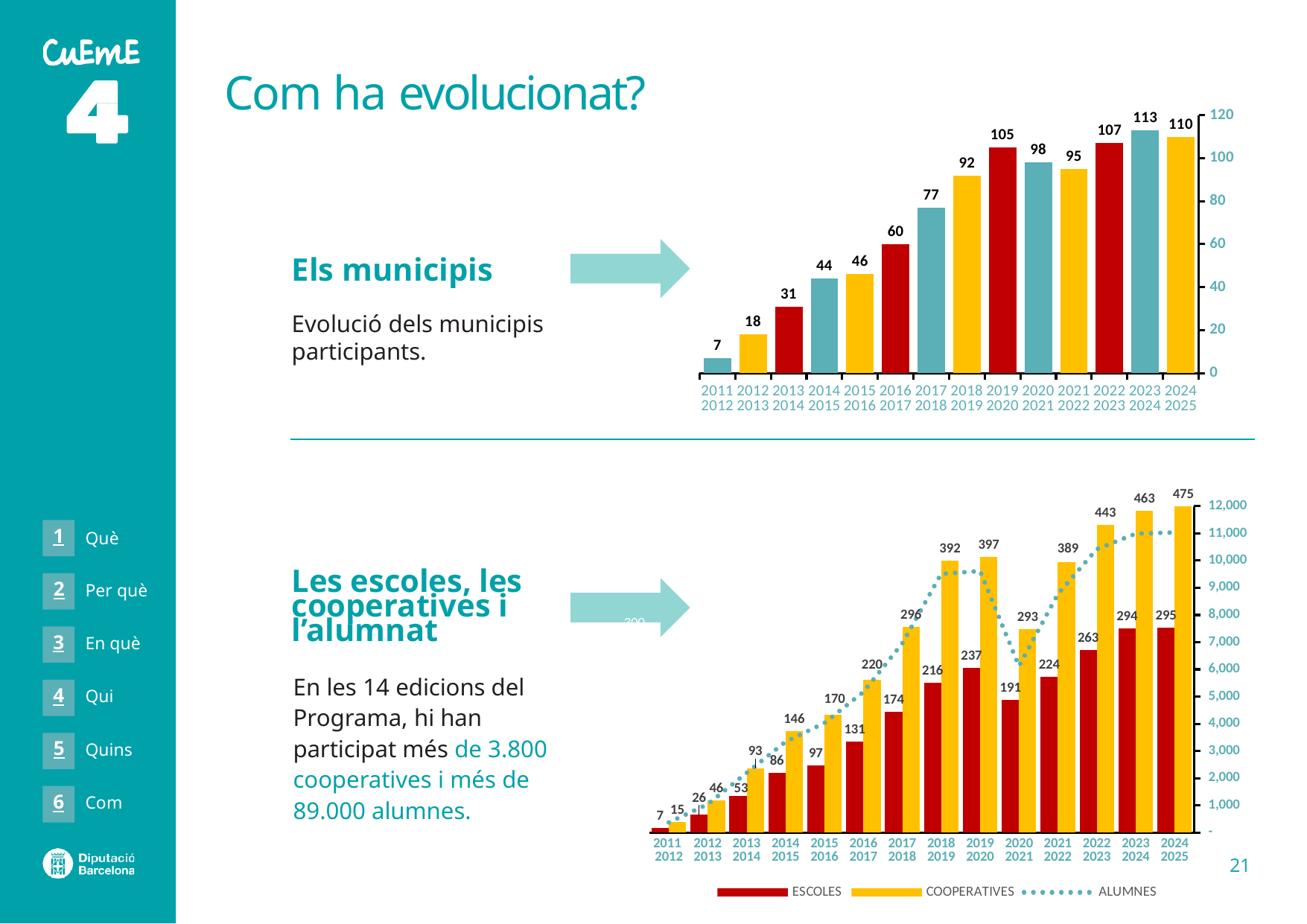
In the bottom chart (Les escoles, les cooperatives i l'alumnat), which series is shown as a dotted line? ALUMNES In the bottom chart (Les escoles, les cooperatives i l'alumnat), which is larger in 2019-2020: ESCOLES or COOPERATIVES? COOPERATIVES In the top chart (Els municipis), is the value for 2017-2018 greater or less than 80? less In the top chart (Els municipis), which edition has the lowest value? 2011-2012 In the top chart (Els municipis), how many editions (bars) are shown? 14 In the bottom chart (Les escoles, les cooperatives i l'alumnat), what is the COOPERATIVES value for 2024-2025? 475 In the top chart (Els municipis), how many municipalities participated in 2019-2020? 105 In the top chart (Els municipis), which edition has the highest value? 2023-2024 In the bottom chart (Les escoles, les cooperatives i l'alumnat), what is the difference between the COOPERATIVES values for 2019-2020 and 2020-2021? 104 In the bottom chart (Les escoles, les cooperatives i l'alumnat), how many series does the legend list? 3 In the top chart (Els municipis), what is the difference between the values for 2023-2024 and 2011-2012? 106 In the bottom chart (Les escoles, les cooperatives i l'alumnat), what is the ESCOLES value for 2020-2021? 191